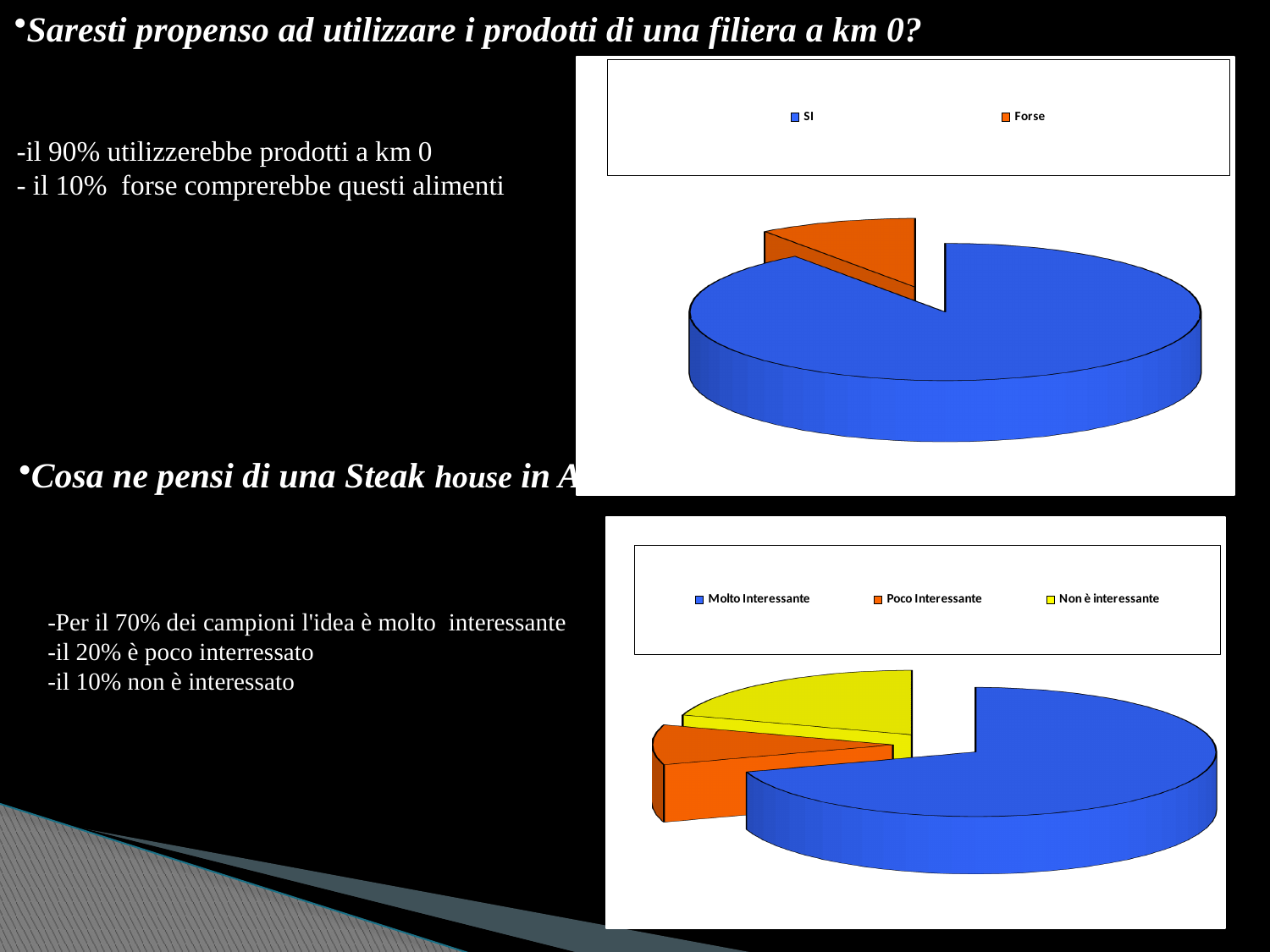
In the top chart, what colour is the slice for Forse? orange In the top chart, which category has the largest slice? SI In the bottom chart, what colour is the slice for Non è interessante? yellow What type of chart is the bottom chart on the slide? pie chart How many entries does the legend of the top chart list? 2 How many entries does the legend of the bottom chart list? 3 In the bottom chart, how many slices does the pie have? 3 In the top chart, how many slices does the pie have? 2 In the bottom chart, which category has the largest slice? Molto Interessante In the bottom chart, which slice is larger: Molto Interessante or Poco Interessante? Molto Interessante What type of chart is the top chart on the slide? pie chart In the top chart, which category has the smallest slice? Forse